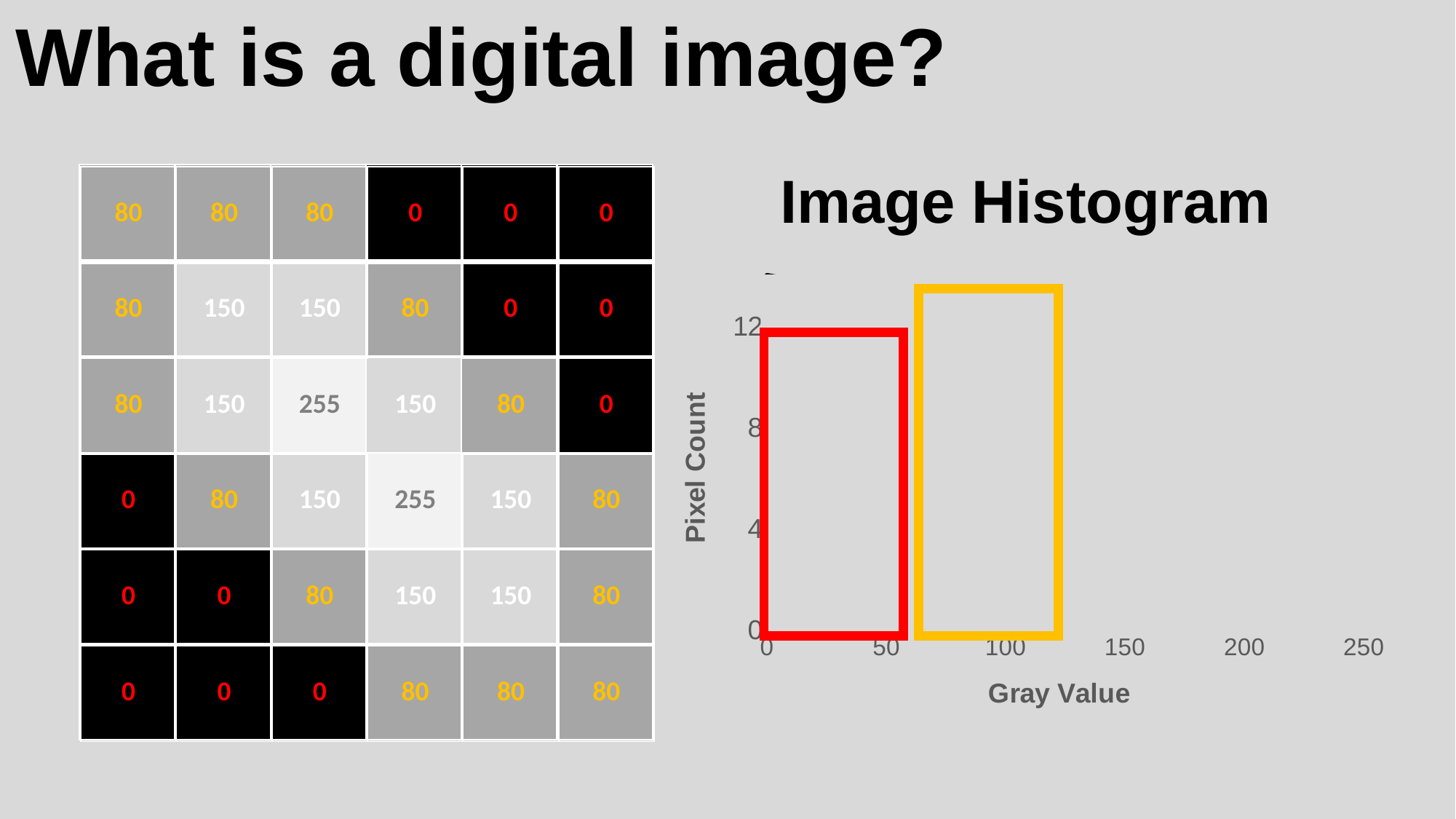
In the Image Histogram chart, is the pixel count of the red bar greater or less than 8? greater What is the title of the chart on the right of the slide? Image Histogram What kind of chart is the Image Histogram? bar chart In the Image Histogram chart, is the pixel count of the red bar greater or less than 4? greater In the Image Histogram chart, is the pixel count of the yellow bar greater or less than 12? greater In the Image Histogram chart, which bar has the lowest pixel count? the red bar What is the label of the horizontal axis of the Image Histogram chart? Gray Value In the Image Histogram chart, do the bar heights rise or fall from left to right along the Gray Value axis? rise In the Image Histogram chart, which bar is taller, the red bar or the yellow bar? the yellow bar How many bars are plotted in the Image Histogram chart? 2 In the Image Histogram chart, which bar has the highest pixel count? the yellow bar